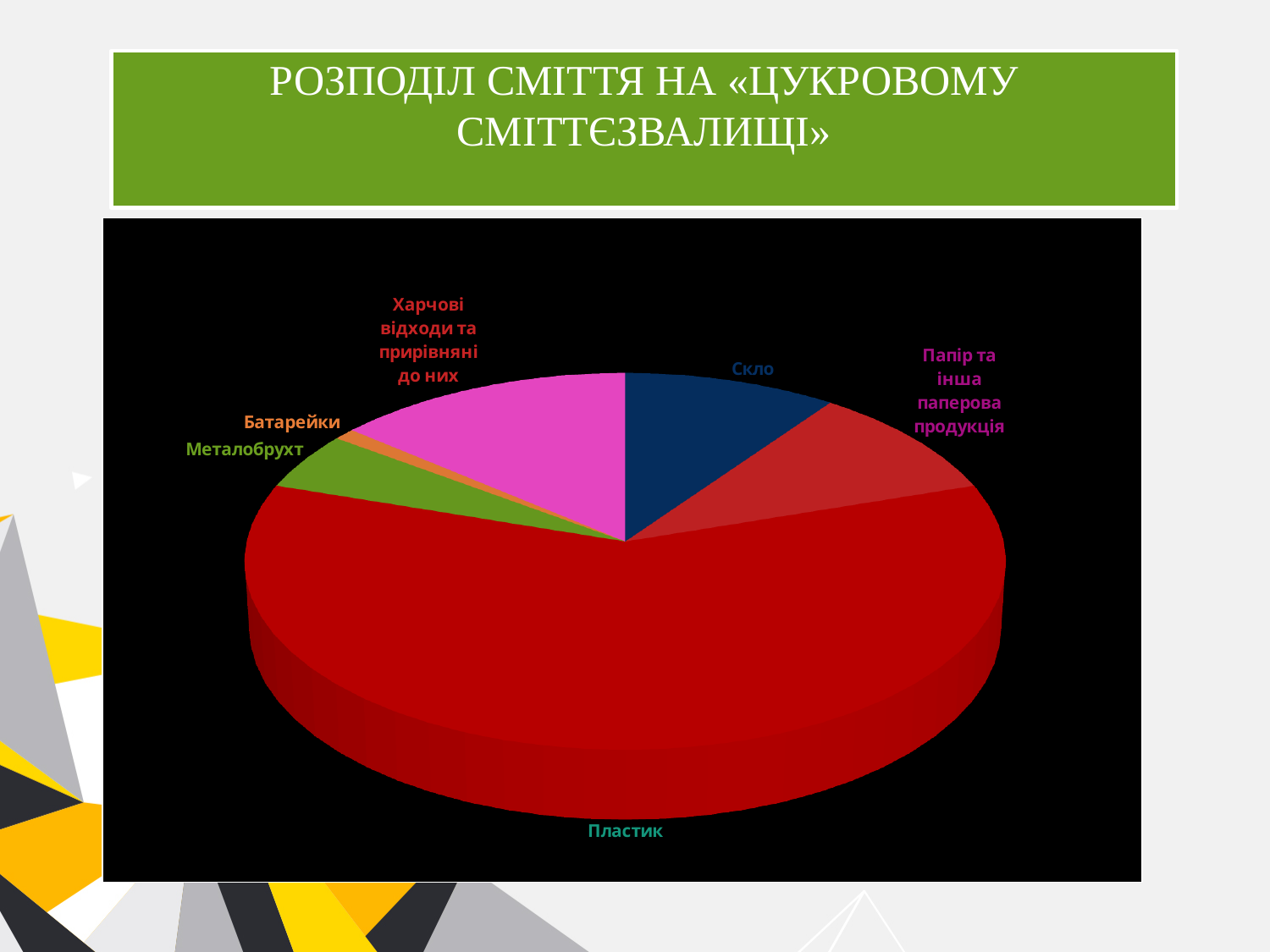
Which slice is larger, Скло or Металобрухт? Скло Which slice is larger, Пластик or Скло? Пластик Which category has the smallest slice of the pie? Батарейки How many categories (slices) does the pie chart show? 6 Which slice is larger, Харчові відходи та прирівняні до них or Металобрухт? Харчові відходи та прирівняні до них What kind of chart is shown on the slide? pie chart Does the Пластик slice make up more or less than half of the pie? more Which category has the largest slice of the pie? Пластик What colour is the Скло slice in the pie chart? dark blue What is the title of the slide containing the chart? РОЗПОДІЛ СМІТТЯ НА «ЦУКРОВОМУ СМІТТЄЗВАЛИЩІ»